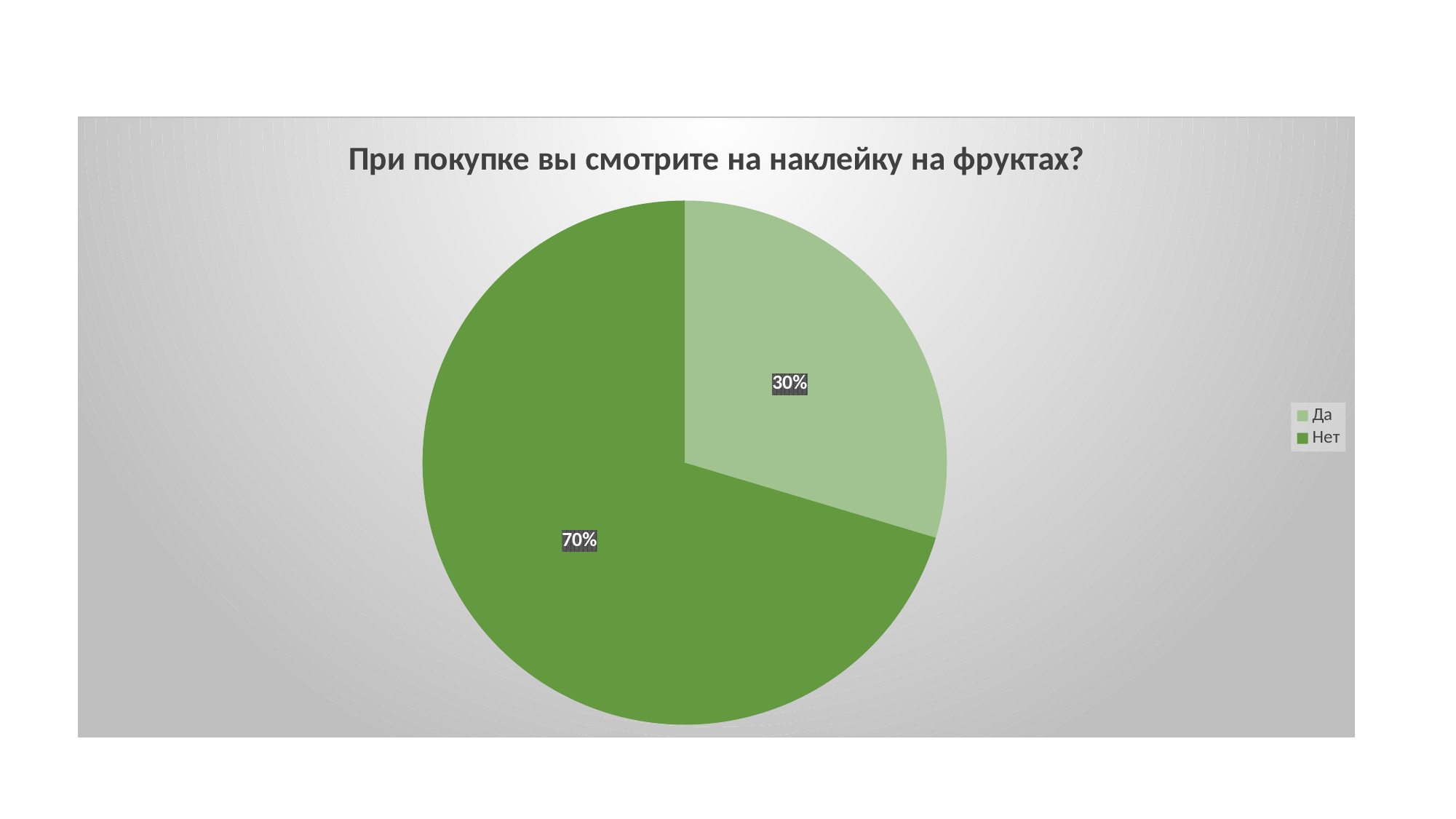
What share of the pie does the "Нет" slice represent? 70% How many entries does the legend list? 2 What is the title of the chart? При покупке вы смотрите на наклейку на фруктах? Which slice is the largest? Нет How many slices does the pie chart have? 2 Which is larger, the "Да" slice or the "Нет" slice? Нет Which slice is the smallest? Да What share of the pie does the "Да" slice represent? 30% What is the difference in percentage points between the "Нет" slice and the "Да" slice? 40% Which legend entry is shown in the darker green colour? Нет What kind of chart is shown on the slide? pie chart